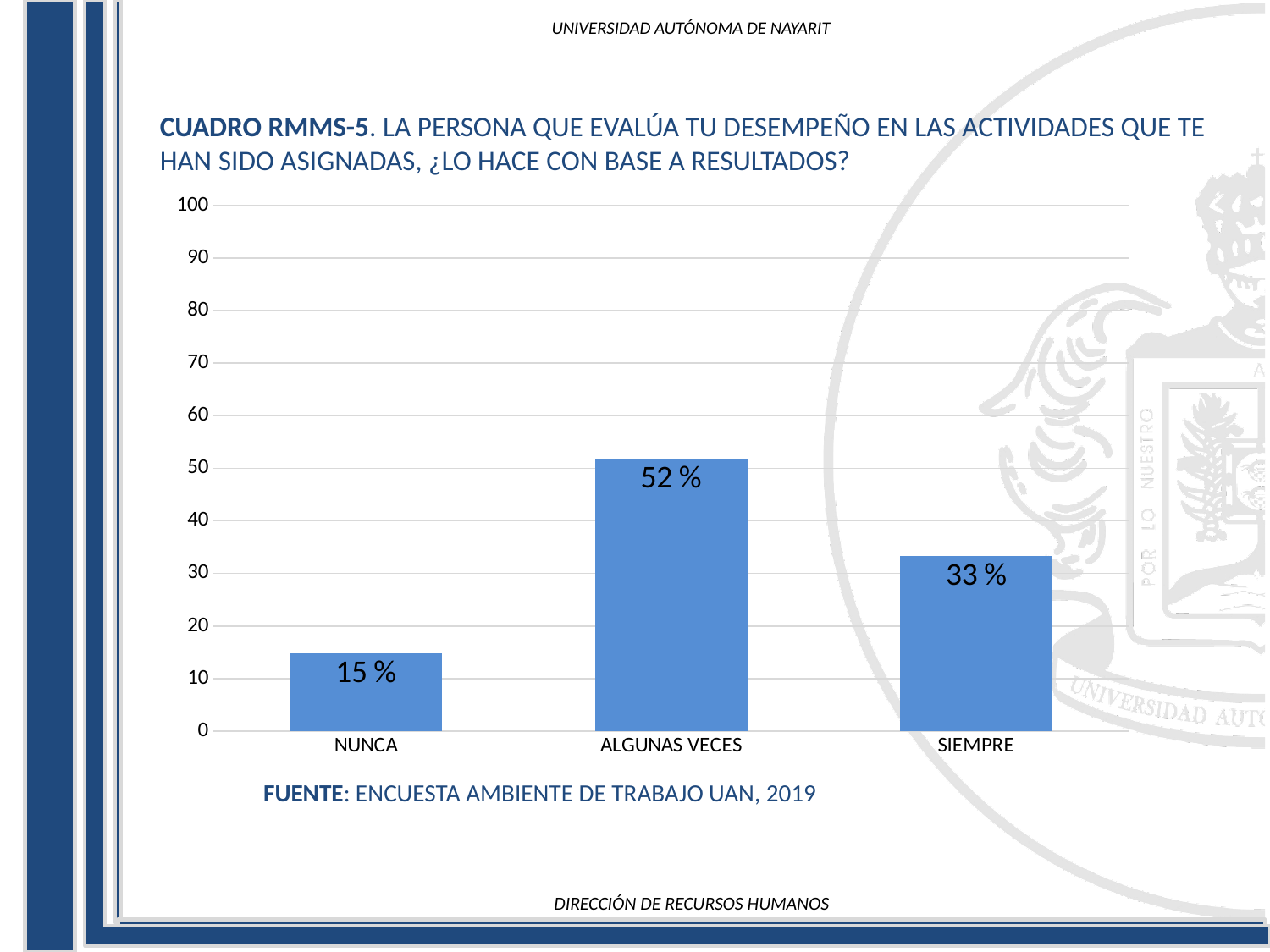
What is the value for ALGUNAS VECES? 52 % Is the value for ALGUNAS VECES greater or less than 50? greater What is the difference between the values for ALGUNAS VECES and SIEMPRE? 19 % What kind of chart is shown on the slide? bar chart What is the value for SIEMPRE? 33 % What is the source cited below the chart? ENCUESTA AMBIENTE DE TRABAJO UAN, 2019 How many categories are shown on the x axis? 3 Which is larger, the value for SIEMPRE or the value for NUNCA? SIEMPRE What is the difference between the values for SIEMPRE and NUNCA? 18 % Which category has the lowest value? NUNCA Which category has the highest value? ALGUNAS VECES What is the value for NUNCA? 15 %